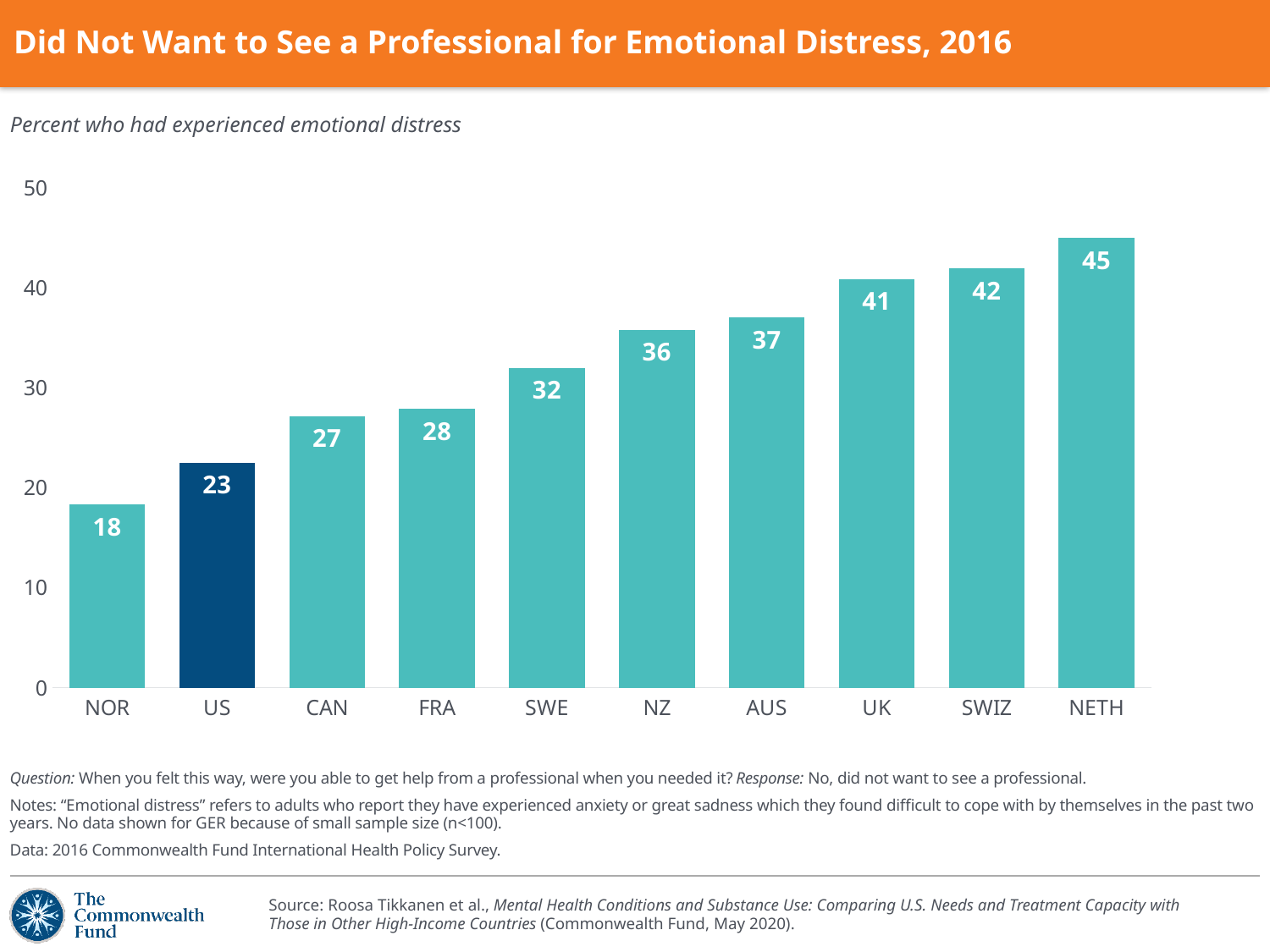
Which is larger, the value for AUS or the value for FRA? AUS What is the difference between the values for NETH and the US? 22 How many countries are shown in the chart? 10 Do the values rise or fall from left to right across the x axis? rise Which country has the lowest value? NOR Which country's bar is shown in a darker blue colour than the others? US What is the difference between the values for UK and CAN? 14 Which country has the highest value? NETH Is the value for NZ greater or less than 30? greater What is the value for the US? 23 What is the value for SWE? 32 What kind of chart is shown on the slide? bar chart